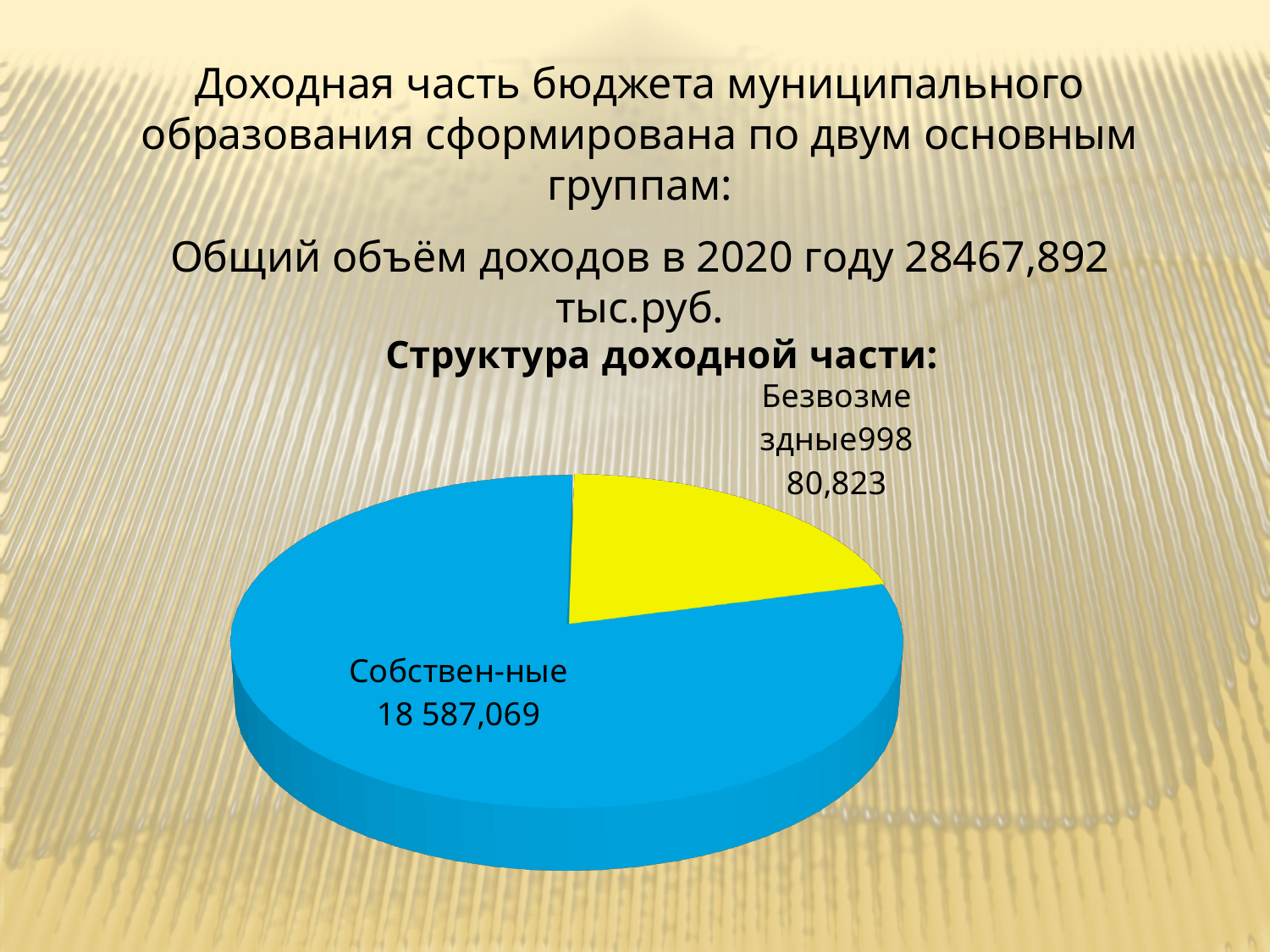
Which is larger, the Собственные slice or the Безвозмездные slice? Собственные Which slice of the pie chart is the largest? Собственные What is the title of the pie chart? Структура доходной части: What value is shown for the Собственные slice? 18 587,069 What kind of chart is shown on the slide? pie chart Which slice of the pie chart is the smallest? Безвозмездные How many slices does the pie chart have? 2 What colour is the Безвозмездные slice? yellow